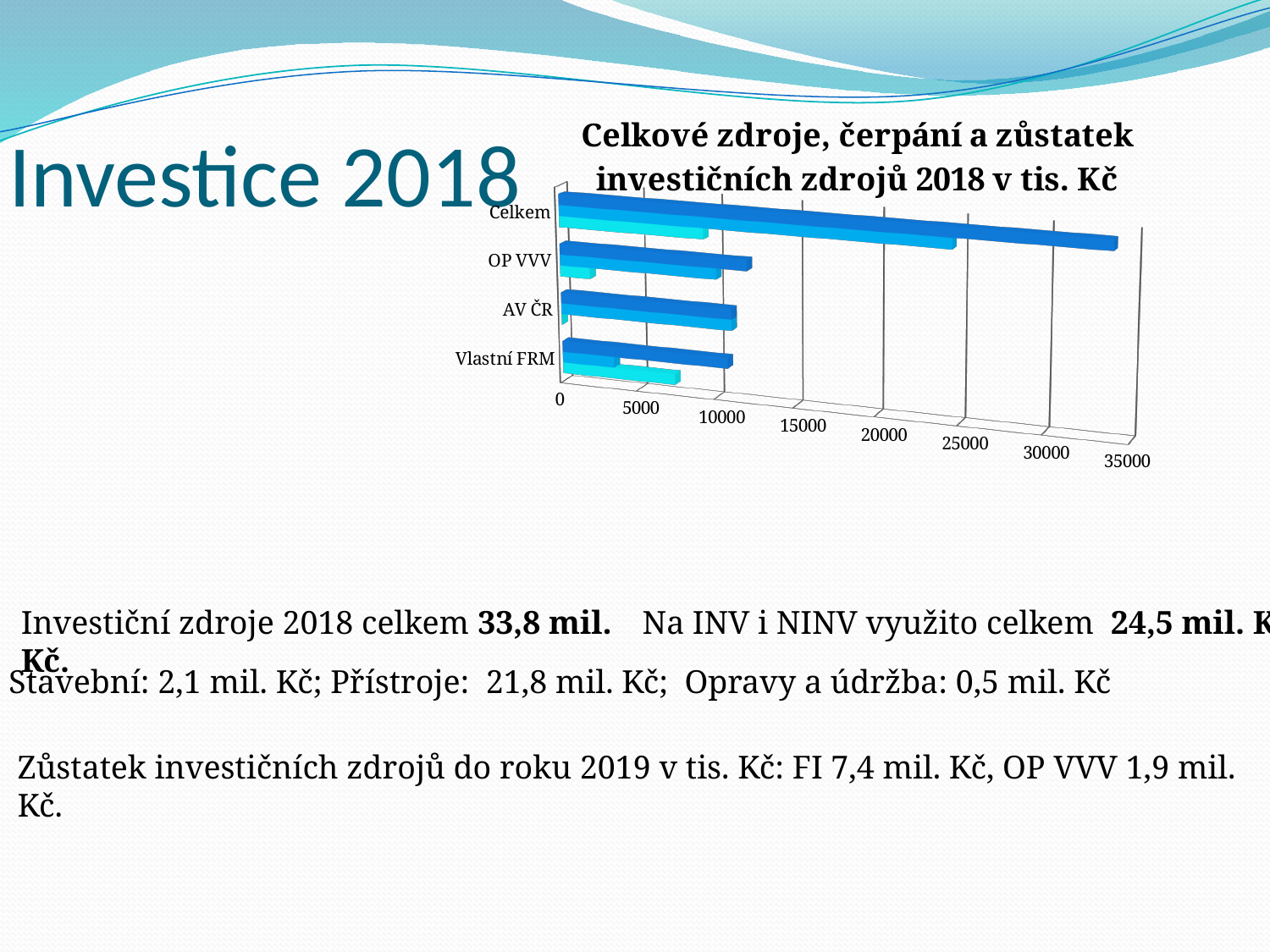
What is the title of the chart? Celkové zdroje, čerpání a zůstatek investičních zdrojů 2018 v tis. Kč Is the bottom (light cyan) bar for Vlastní FRM greater or less than 10000? less What kind of chart is shown on the slide? bar chart Is the middle (medium blue) bar for Celkem greater or less than 20000? greater Is the longest (dark blue) bar for Celkem greater or less than 30000? greater Which has the longer top (dark blue) bar, Celkem or AV ČR? Celkem Which has the longer top (dark blue) bar, Celkem or OP VVV? Celkem Which category has the longest bar in the chart? Celkem What is the highest value shown on the horizontal axis of the chart? 35000 How many categories are shown on the vertical axis of the chart? 4